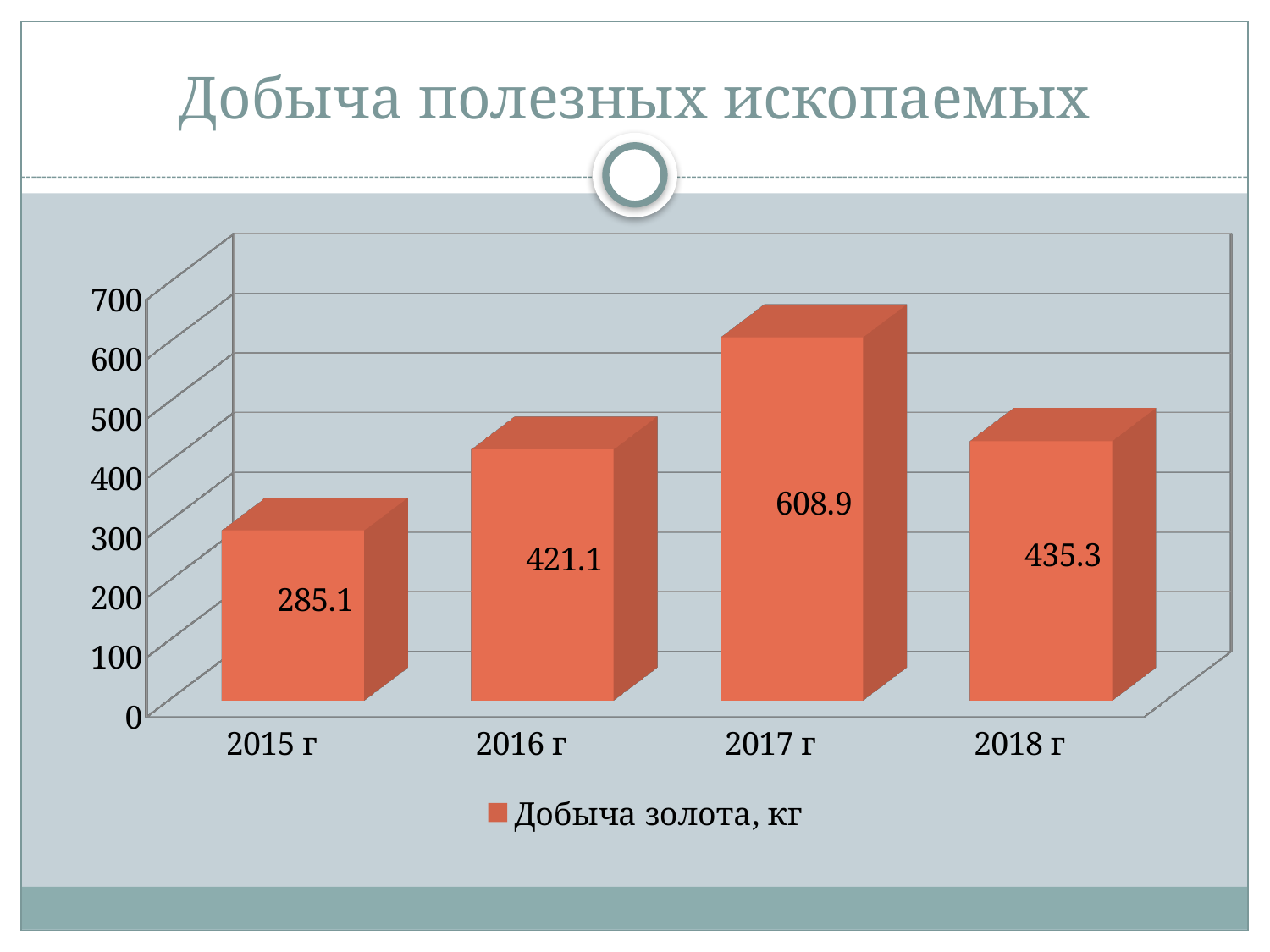
How many years are shown on the x axis? 4 What is the value for 2018 г? 435.3 Which is larger, the value for 2016 г or the value for 2018 г? 2018 г Which year has the lowest value? 2015 г Which year has the highest value? 2017 г What is the value for 2017 г? 608.9 What is the value for 2015 г? 285.1 Is the value for 2016 г greater or less than 400? greater What is the difference between the values for 2017 г and 2016 г? 187.8 What is the legend entry of the series shown? Добыча золота, кг How many series does the legend list? 1 What kind of chart is shown on the slide? bar chart